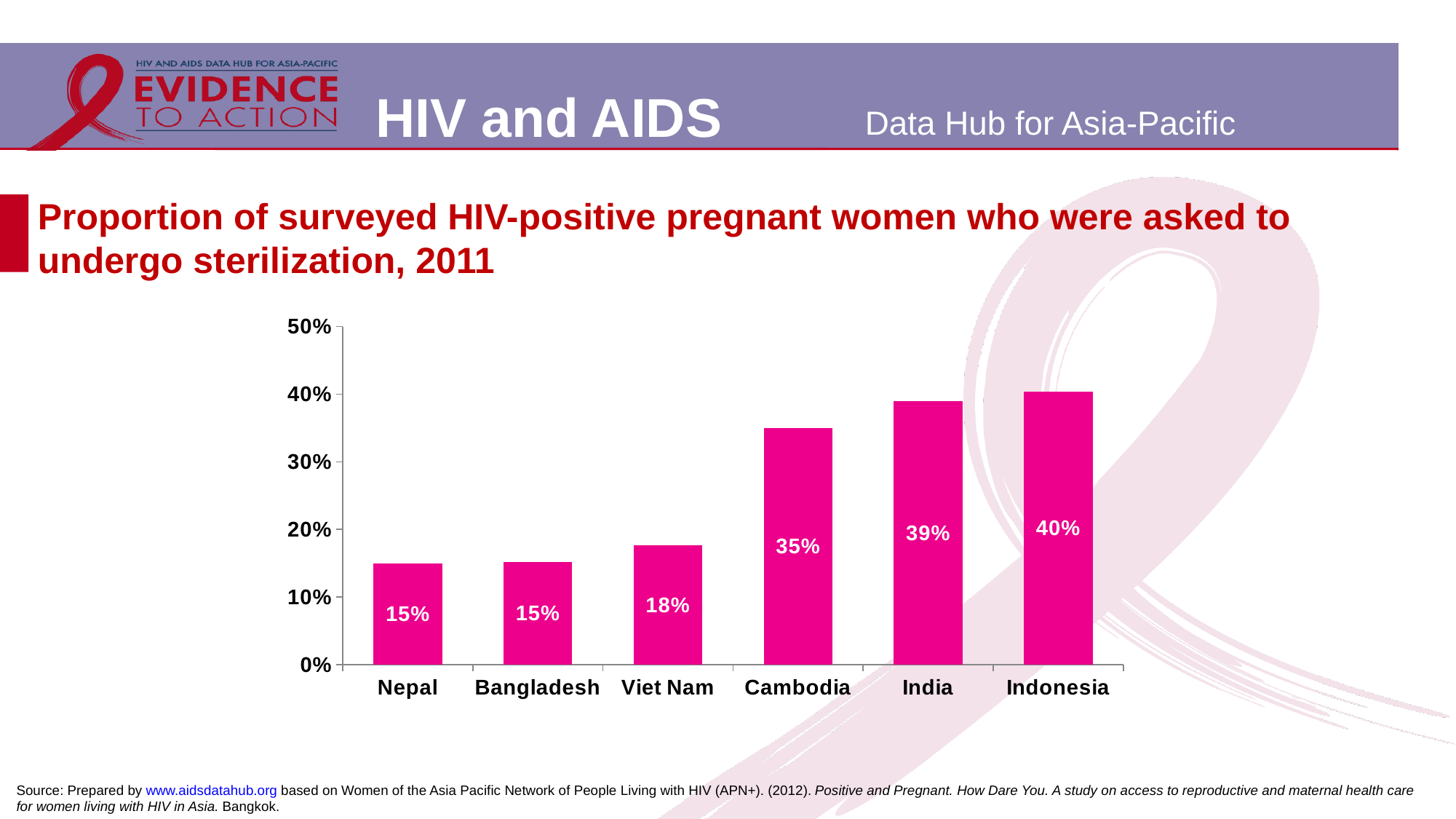
Which is larger, the value for Cambodia or the value for Bangladesh? Cambodia What kind of chart is shown on the slide? Bar chart What is the difference between the values for Cambodia and Viet Nam? 17 percentage points What is the value shown for India? 39% What is the value shown for Nepal? 15% What is the difference between the values for Indonesia and Nepal? 25 percentage points Which country has the highest proportion of surveyed HIV-positive pregnant women asked to undergo sterilization? Indonesia Is the value for India greater or less than 30%? greater What year does the chart title refer to? 2011 How many countries are shown on the chart? 6 What proportion of surveyed HIV-positive pregnant women in Cambodia were asked to undergo sterilization? 35% What is the value shown for Viet Nam? 18%